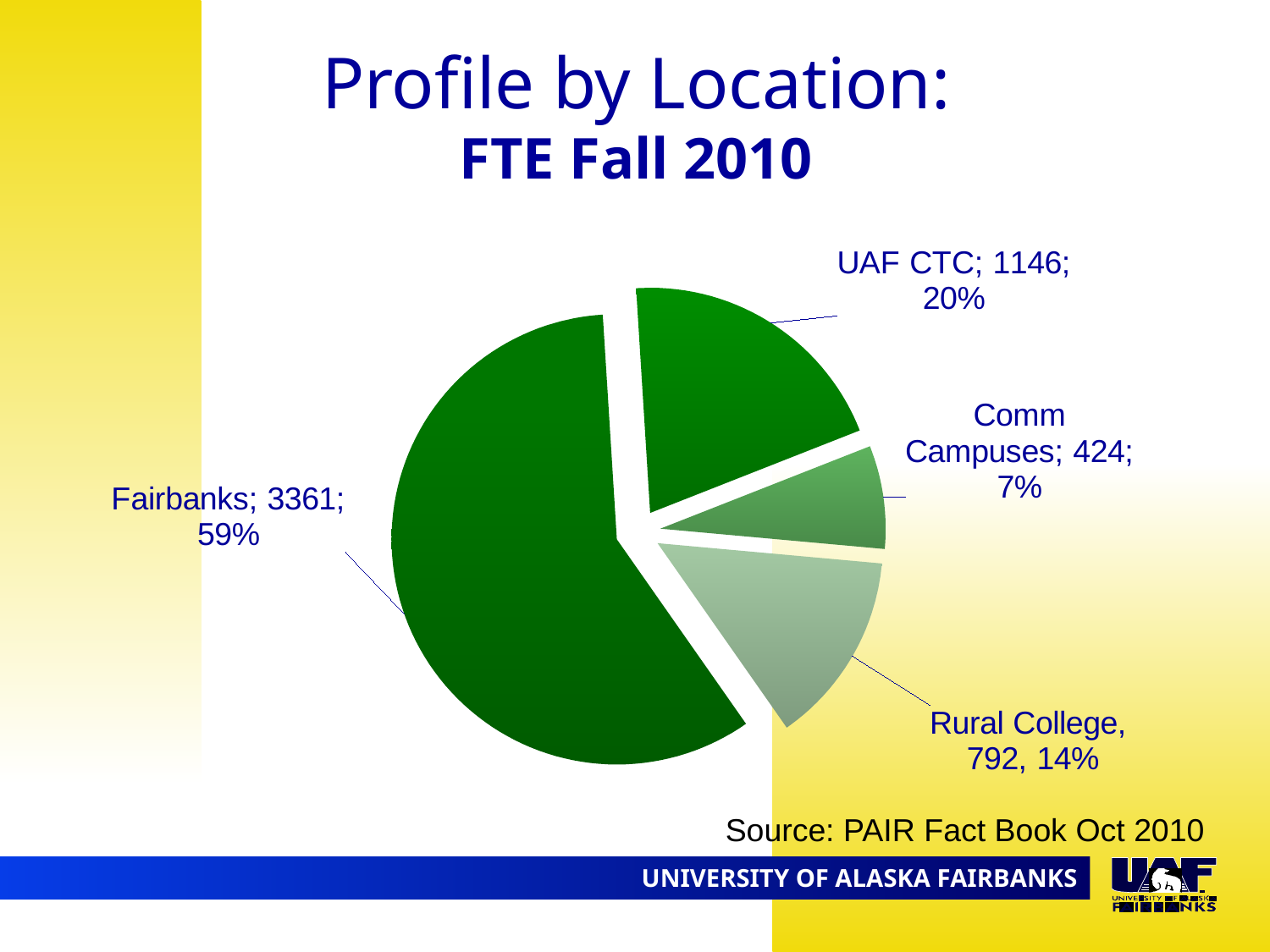
Which location has the smallest slice of the pie? Comm Campuses Which has a larger FTE, Rural College or Comm Campuses? Rural College What type of chart is shown on the slide? pie chart How many slices does the pie chart have? 4 What share of the pie does Fairbanks represent? 59% What share of the pie does Rural College represent? 14% What is the FTE value for Fairbanks? 3361 What is the FTE value for Rural College? 792 What is the FTE value for Comm Campuses? 424 Which location has the largest slice of the pie? Fairbanks What is the FTE value for UAF CTC? 1146 What is the difference in FTE between UAF CTC and Rural College? 354